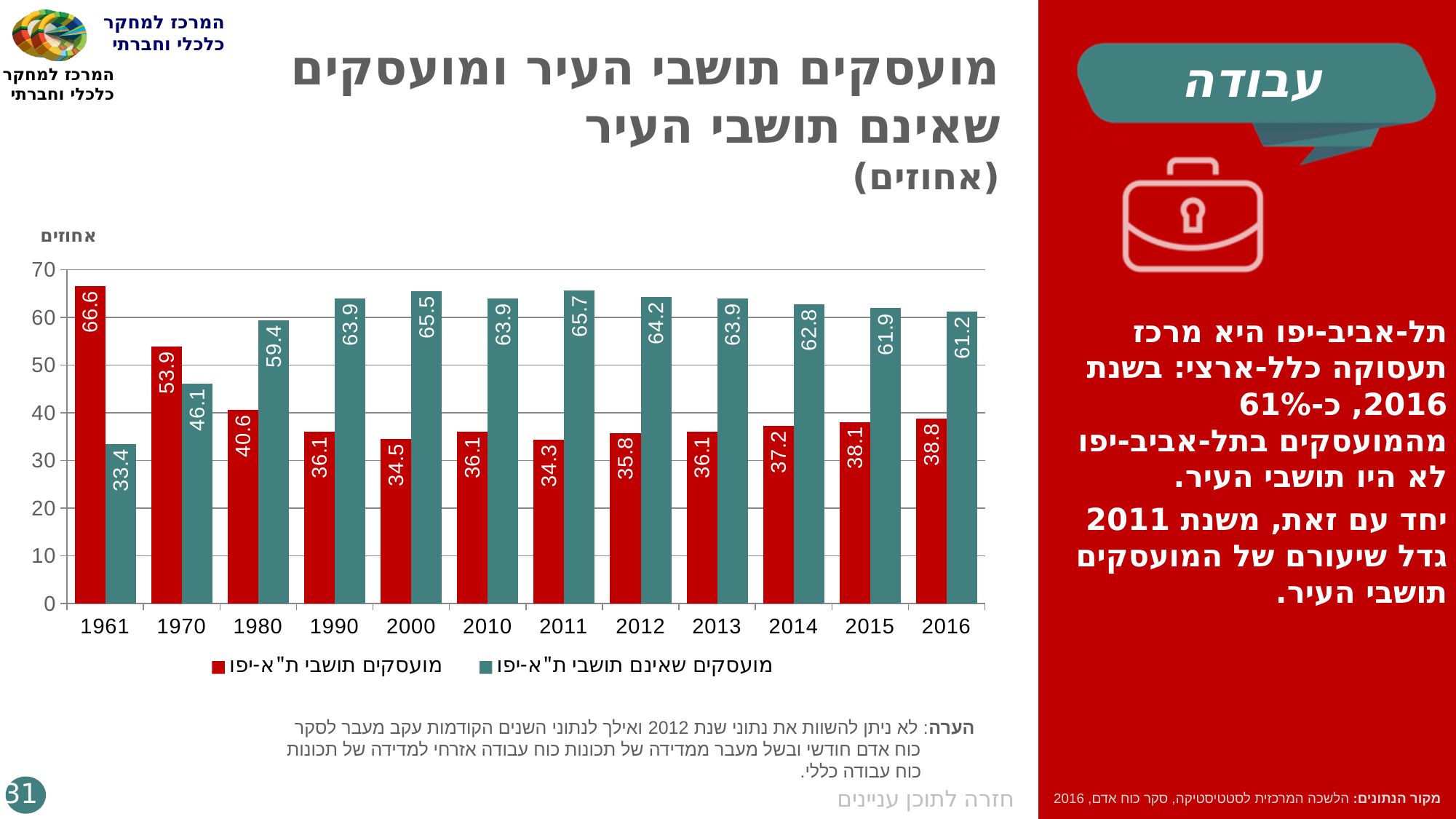
What is the difference between the two series' values in 2016? 22.4 What colour are the bars for the series "מועסקים שאינם תושבי ת"א-יפו"? teal In which year is the value for the series "מועסקים תושבי ת"א-יפו" lowest? 2011 How many years are shown on the x axis of the chart? 12 How many series does the chart's legend list? 2 In which year is the value for the series "מועסקים שאינם תושבי ת"א-יפו" highest? 2011 What is the value for the series "מועסקים תושבי ת"א-יפו" in 2011? 34.3 What is the value for the series "מועסקים תושבי ת"א-יפו" in 1961? 66.6 From 2011 to 2016, does the value for the series "מועסקים תושבי ת"א-יפו" rise or fall? rise In 1970, which series has the larger value: "מועסקים תושבי ת"א-יפו" or "מועסקים שאינם תושבי ת"א-יפו"? מועסקים תושבי ת"א-יפו What kind of chart is shown on the slide? bar chart What is the value for the series "מועסקים שאינם תושבי ת"א-יפו" in 2016? 61.2